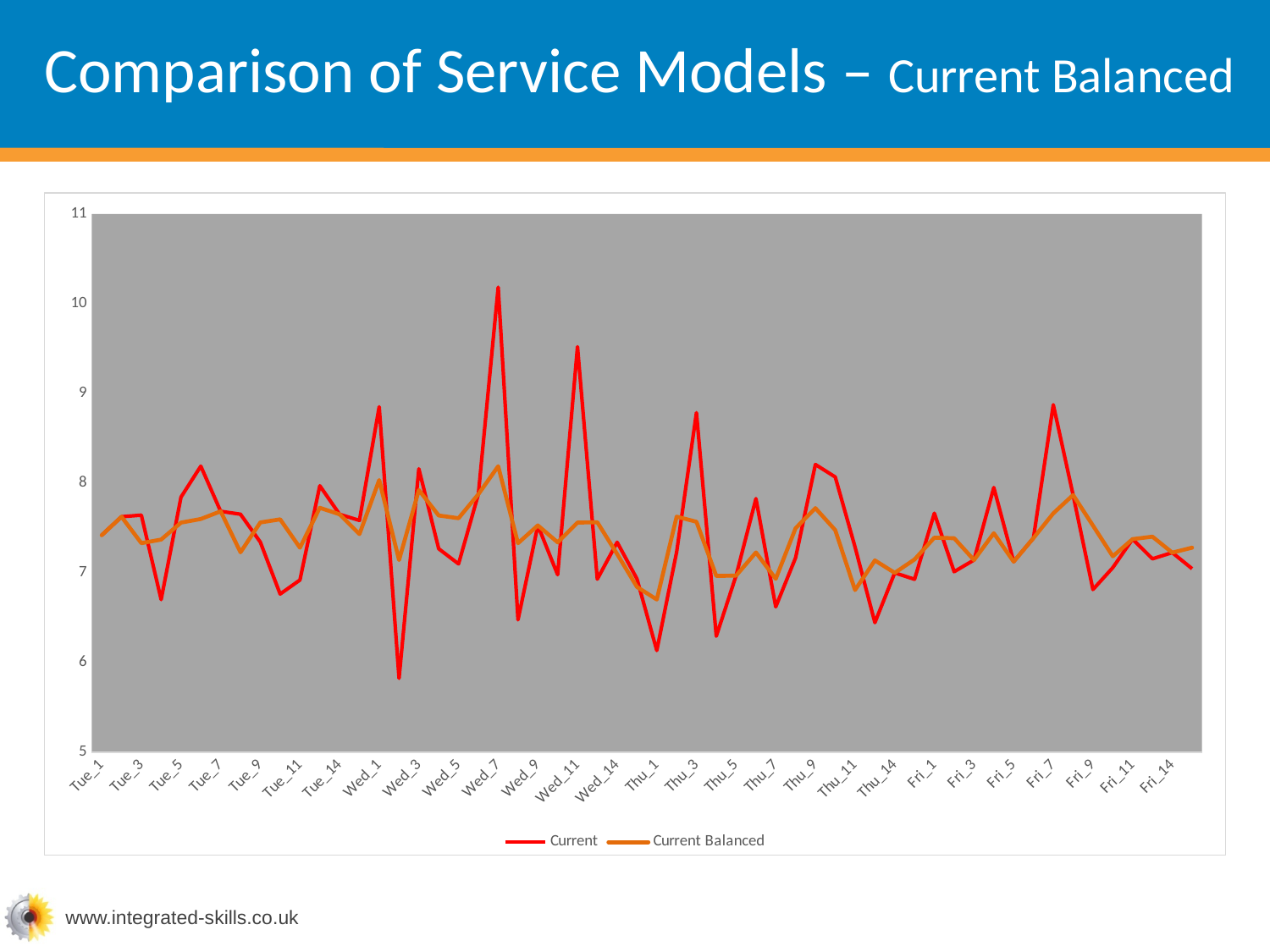
Is the value of the Current series at Wed_7 greater or less than 10? greater At Wed_3, which series has the higher value, Current or Current Balanced? Current At Wed_7, which series has the higher value, Current or Current Balanced? Current Is the value of the Current series at Wed_3 greater or less than 6? greater What colour is the line for the Current series? Red Is the value of the Current Balanced series at Wed_7 greater or less than 8? greater What are the two series named in the legend? Current and Current Balanced At which x-axis label does the Current series reach its highest value? Wed_7 What kind of chart is shown on the slide? Line chart How many series does the legend list? 2